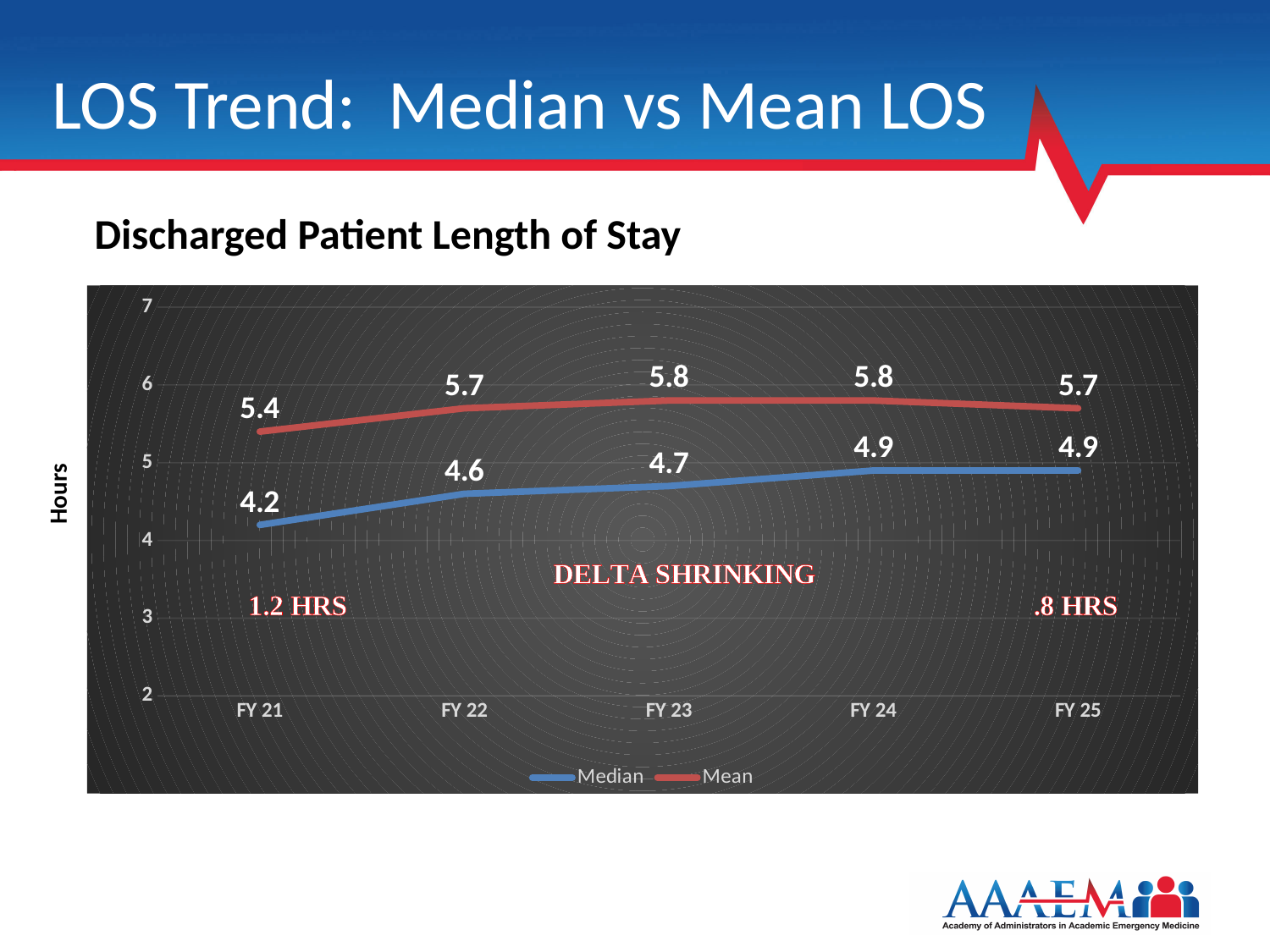
In which fiscal year is the Median length of stay lowest? FY 21 What is the Median length of stay for FY 21? 4.2 What is the Mean length of stay for FY 25? 5.7 What is the Median length of stay for FY 24? 4.9 Which is larger in FY 22, the Mean or the Median length of stay? Mean In which fiscal year is the Mean length of stay lowest? FY 21 How many fiscal years are plotted on the x axis? 5 What is the difference between the Mean and Median length of stay in FY 21? 1.2 What is the Mean length of stay for FY 23? 5.8 What kind of chart is shown on the slide? Line chart How many series does the legend list? 2 What is the difference between the Mean and Median length of stay in FY 25? 0.8